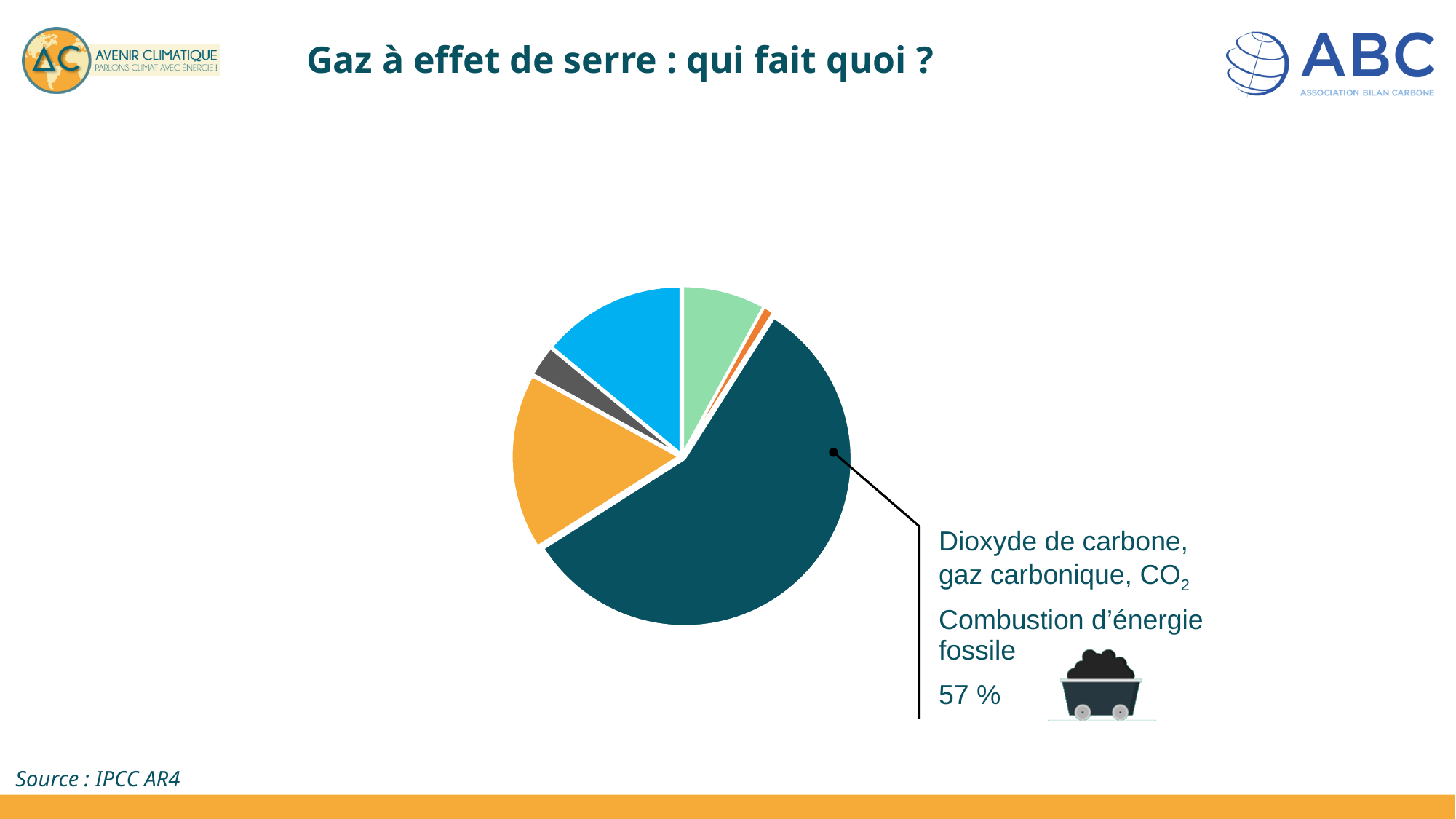
Is the share of the CO2 from fossil fuel combustion slice greater or less than 50%? greater What share of the pie is attributed to carbon dioxide from fossil fuel combustion (Combustion d'énergie fossile)? 57 % How many slices does the pie chart have? 6 What kind of chart is shown on the slide? pie chart What is the title of the slide containing the pie chart? Gaz à effet de serre : qui fait quoi ? What source is cited for the pie chart data? IPCC AR4 What percentage is printed for the slice labelled 'Dioxyde de carbone, gaz carbonique, CO2'? 57 % Does the CO2 from fossil fuel combustion slice account for more or less than half of the pie? more Which slice is the largest in the pie chart? Dioxyde de carbone (CO2), Combustion d'énergie fossile